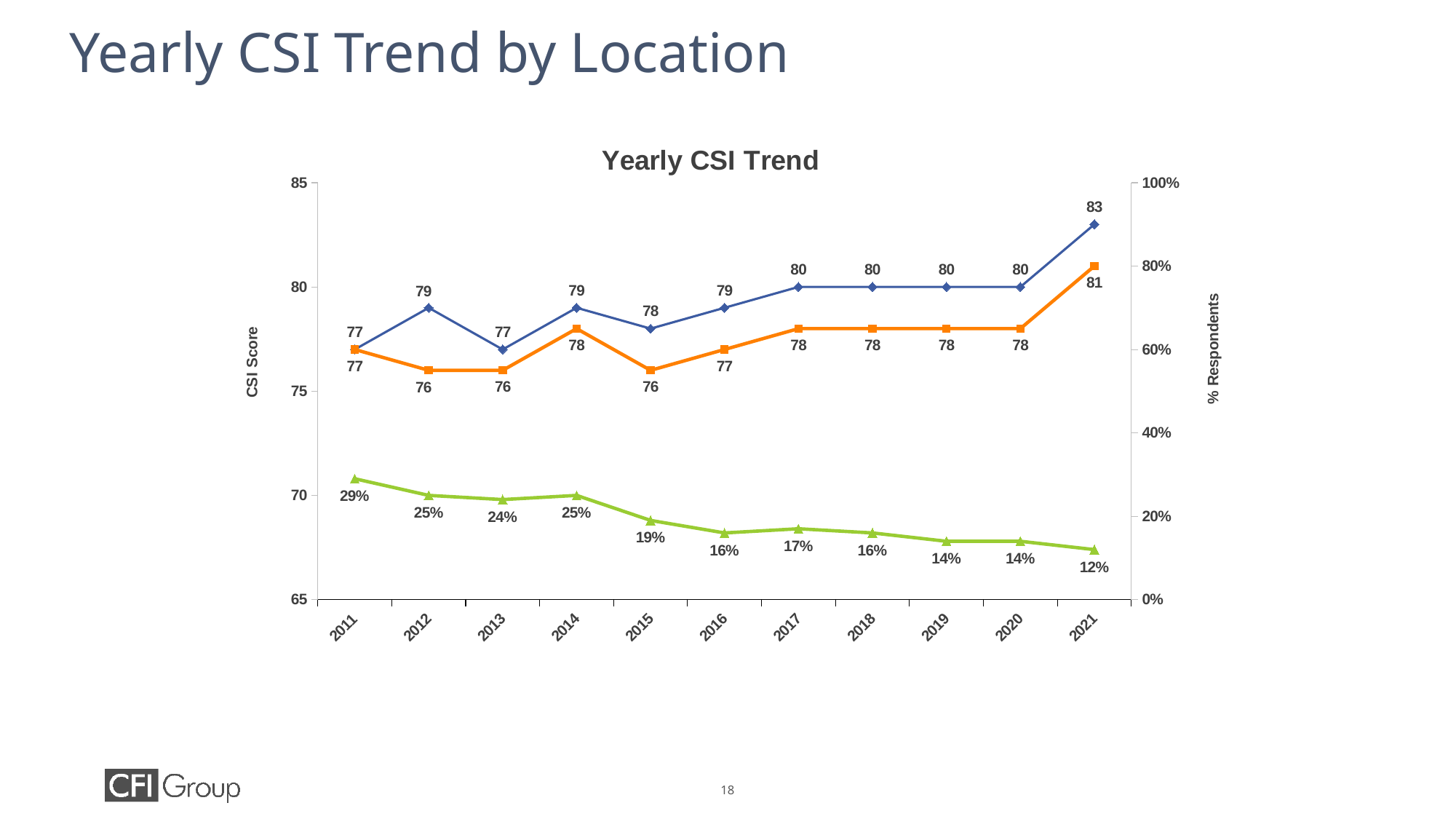
What kind of chart is shown on the slide? Line chart Does the green line (% Respondents) generally rise or fall from 2011 to 2021? Fall What is the difference between the blue line and the orange line in 2012? 3 What is the value of the blue line in 2021? 83 In which year is the green line (% Respondents) at its lowest? 2021 In which year does the blue line reach its highest value? 2021 Which is larger, the orange line's value in 2014 or its value in 2016? 2014 What is the title of the chart? Yearly CSI Trend What is the difference between the green line's value in 2011 and its value in 2021? 17% How many years are plotted along the x axis? 11 What is the value of the orange line in 2015? 76 What percentage of respondents does the green line show for 2011? 29%